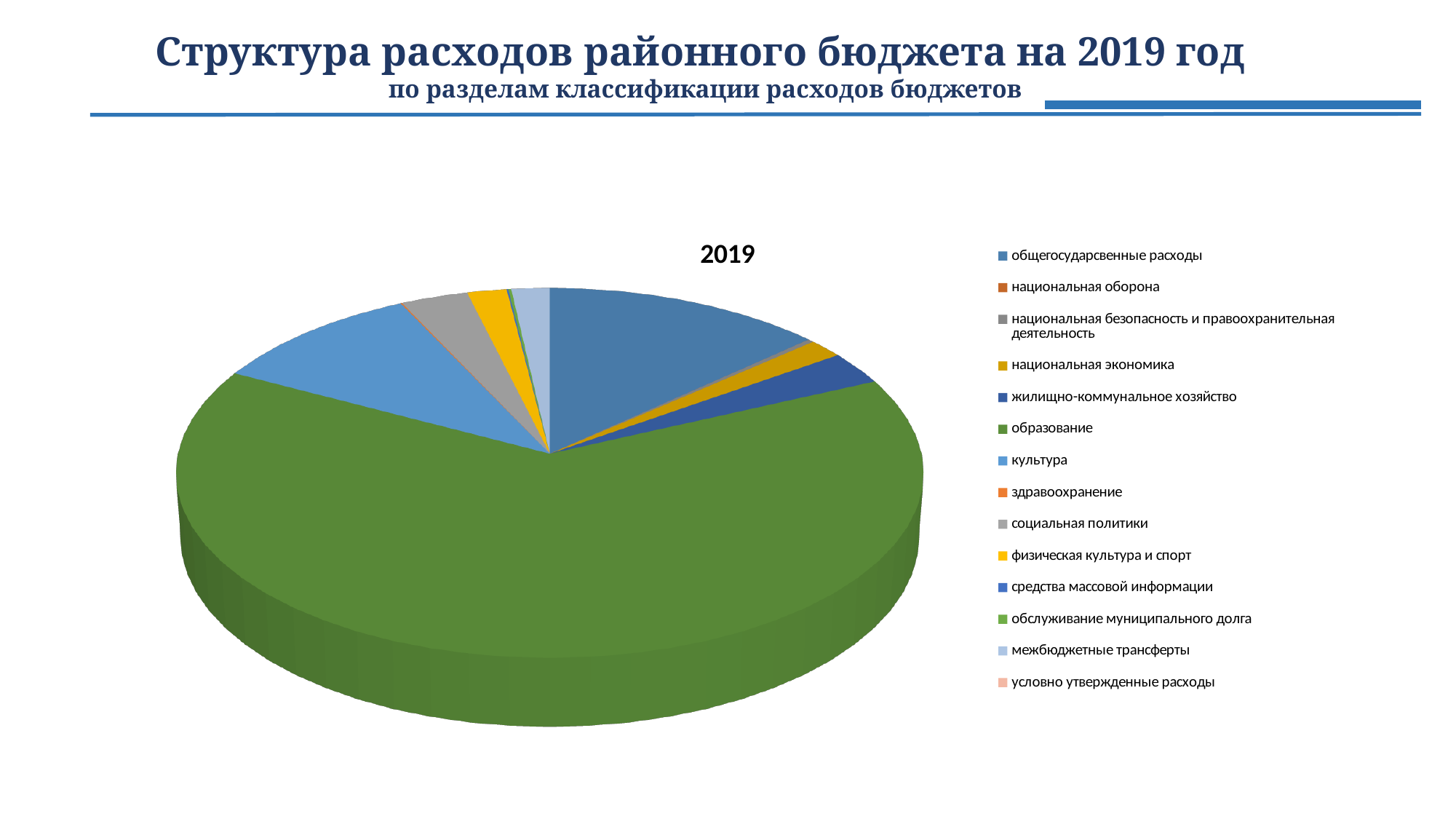
What kind of chart is shown on the slide? pie chart What is the title shown above the pie chart? 2019 Which slice is larger: общегосударсвенные расходы or культура? общегосударсвенные расходы How many categories does the legend of the pie chart list? 14 Which slice is larger: общегосударсвенные расходы or национальная экономика? общегосударсвенные расходы Which category has the largest slice in the pie chart? образование What colour is the образование slice in the pie chart? green Which slice is larger: культура or социальная политики? культура Does the образование slice take up more or less than half of the pie? more than half